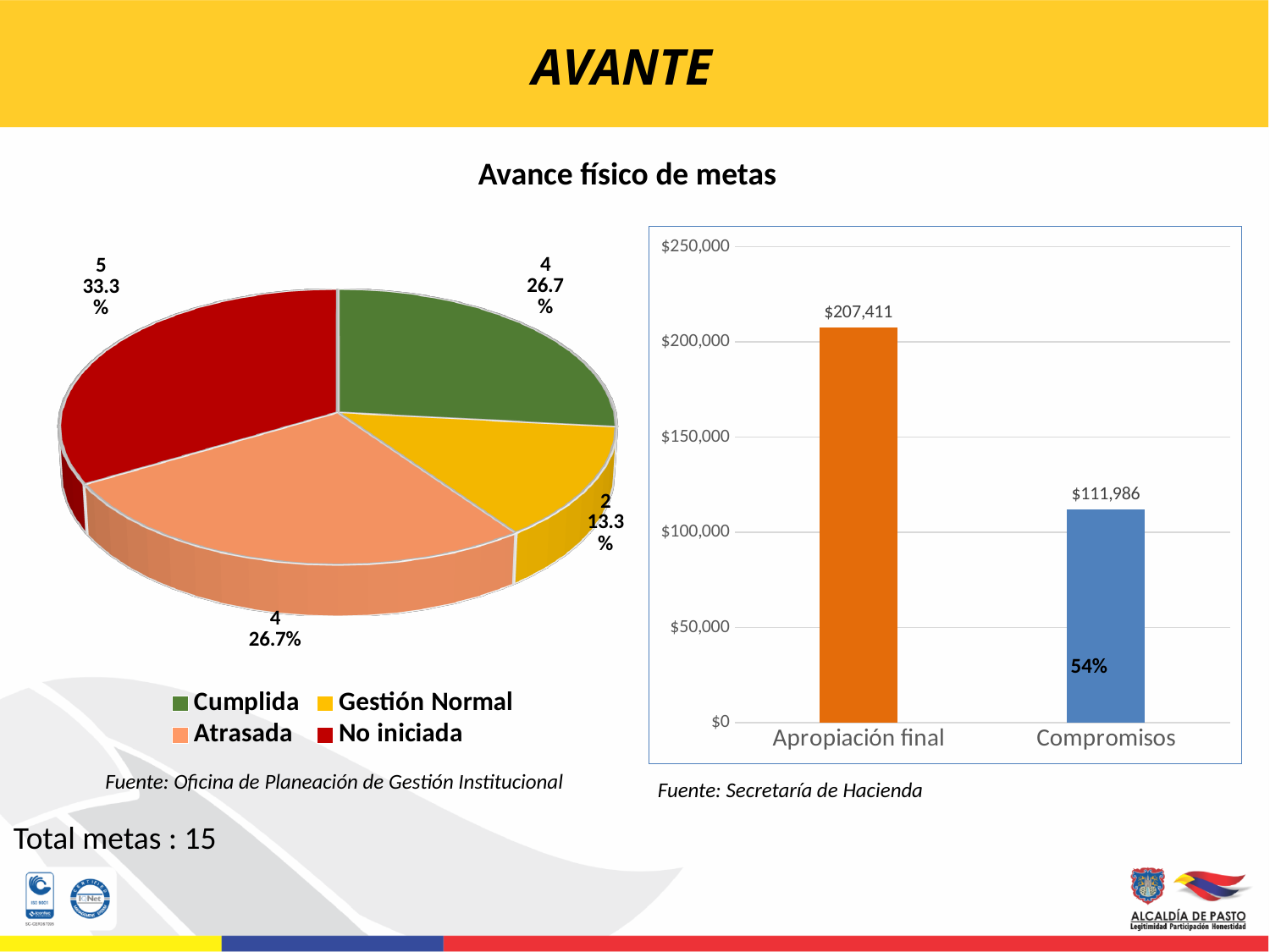
In the pie chart on the left, which category has the largest share? No iniciada In the pie chart on the left, what percentage share does 'Cumplida' have? 26.7% In the pie chart on the left, how many metas are in the 'No iniciada' category? 5 In the pie chart on the left, what percentage share does 'Gestión Normal' have? 13.3% In the pie chart on the left, which category has the smallest share? Gestión Normal In the bar chart on the right, what is the value for 'Apropiación final'? $207,411 How many categories does the legend of the pie chart on the left list? 4 What kind of chart is shown on the right side of the slide? Bar chart In the bar chart on the right, what percentage label is printed on the 'Compromisos' bar? 54% In the bar chart on the right, what is the value for 'Compromisos'? $111,986 In the bar chart on the right, what is the difference between 'Apropiación final' and 'Compromisos'? $95,425 In the bar chart on the right, which is larger, 'Apropiación final' or 'Compromisos'? Apropiación final